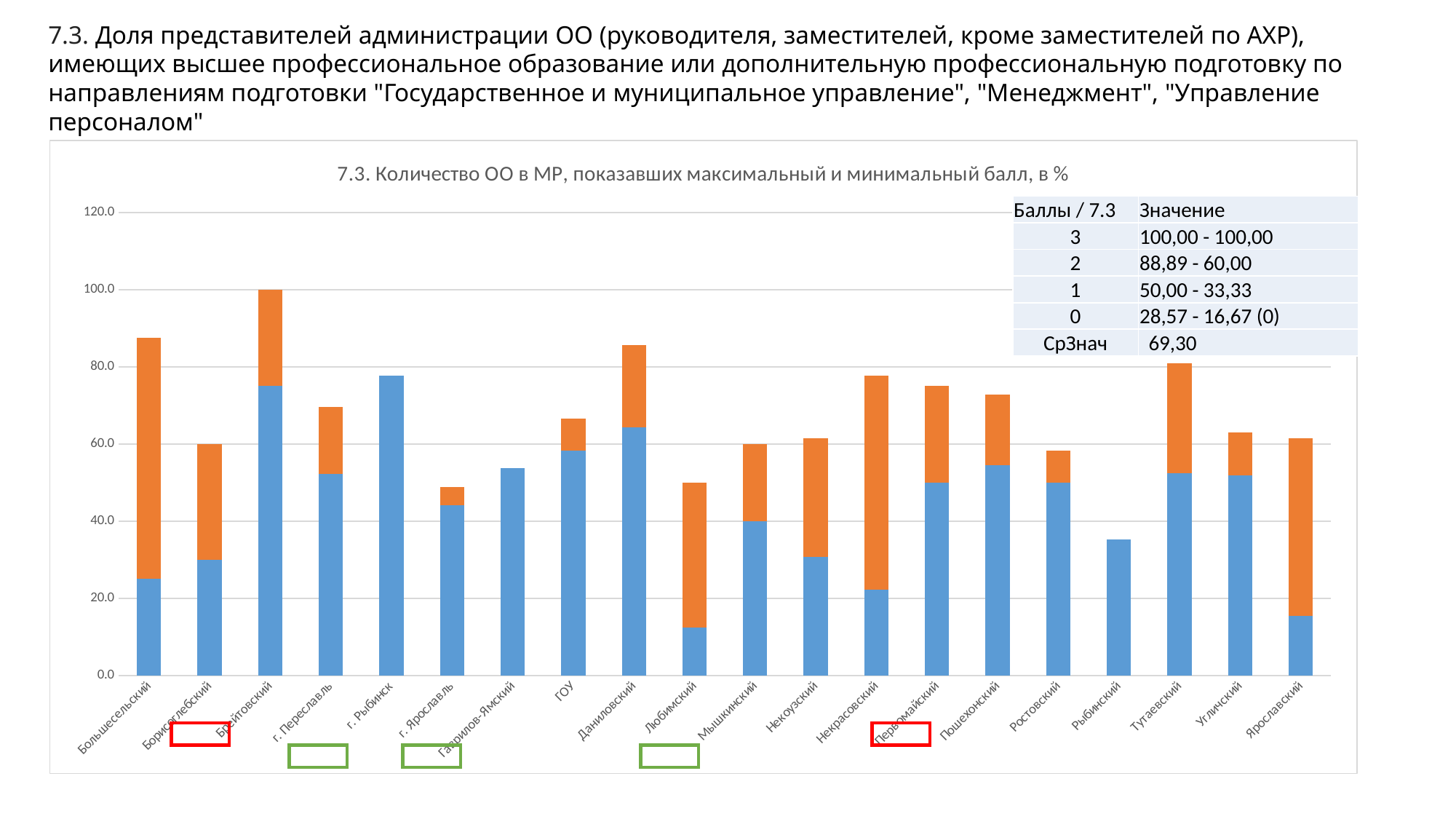
Is the total value for Любимский greater or less than 60? less What is the title of the chart? 7.3. Количество ОО в МР, показавших максимальный и минимальный балл, в % Is the total value for Большесельский greater or less than 80? greater Which category has the shortest stacked bar in the chart? Рыбинский Which has the taller stacked bar, Большесельский or Борисоглебский? Большесельский Which category has the tallest stacked bar in the chart? Брейтовский What kind of chart is shown on the slide? Stacked bar chart Is the total value for Даниловский greater or less than 80? greater What is the total height of the stacked bar for Брейтовский? 100.0 What two colours are used for the segments of the stacked bars? Blue and orange How many categories (municipal districts) are shown on the x axis of the chart? 20